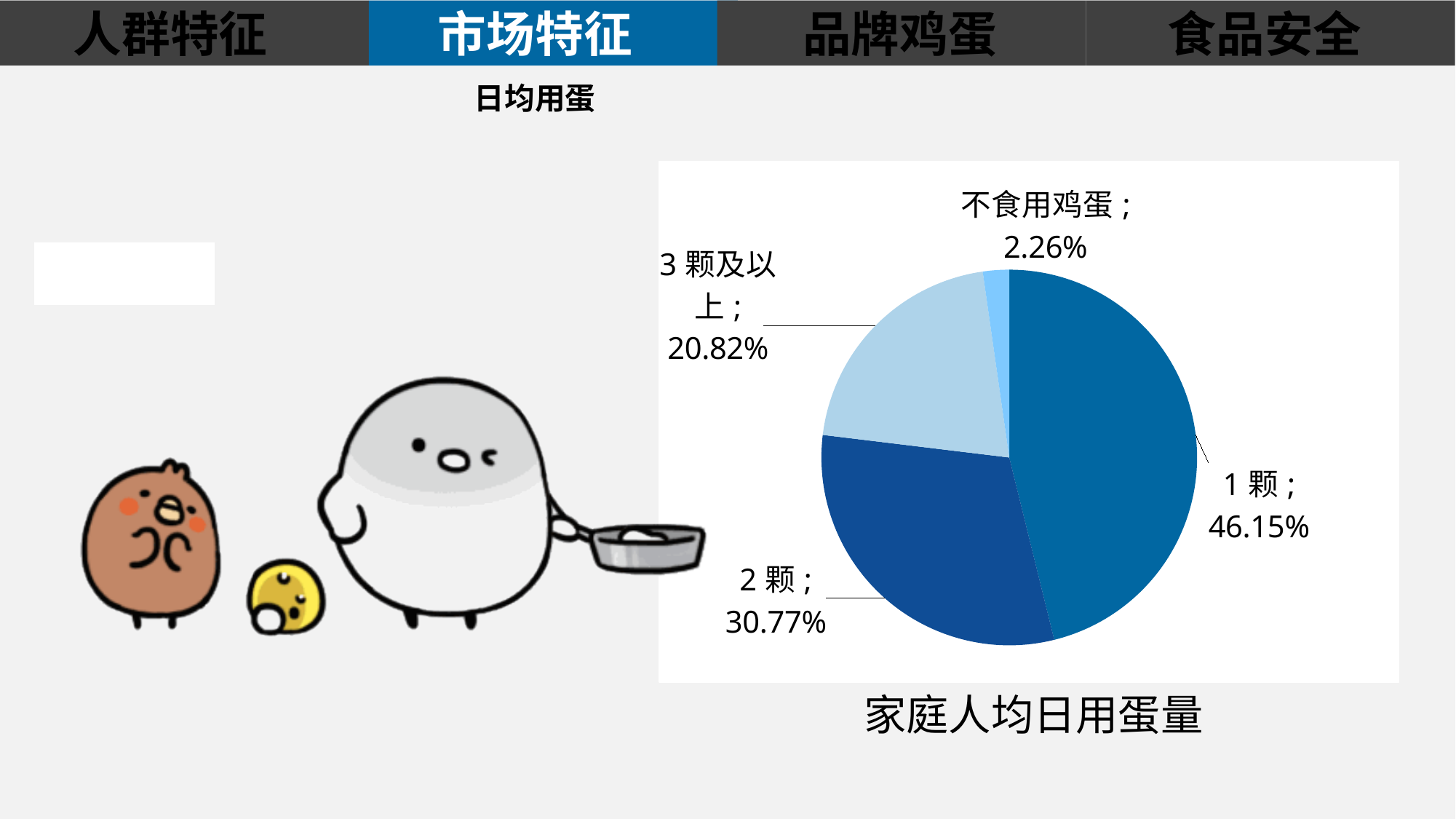
What is the value shown for "不食用鸡蛋"? 2.26% What kind of chart is shown on the slide? Pie chart Which is larger, the share for "2 颗" or the share for "3 颗及以上"? 2 颗 What is the value shown for "2 颗"? 30.77% How many categories does the pie chart show? 4 Which category has the largest share of the pie? 1 颗 What is the difference between the shares for "2 颗" and "3 颗及以上"? 9.95% Which category has the smallest share of the pie? 不食用鸡蛋 What is the title of the chart? 家庭人均日用蛋量 What share of the pie does the "1 颗" slice represent? 46.15% What is the difference between the shares for "1 颗" and "2 颗"? 15.38% What is the value shown for "3 颗及以上"? 20.82%